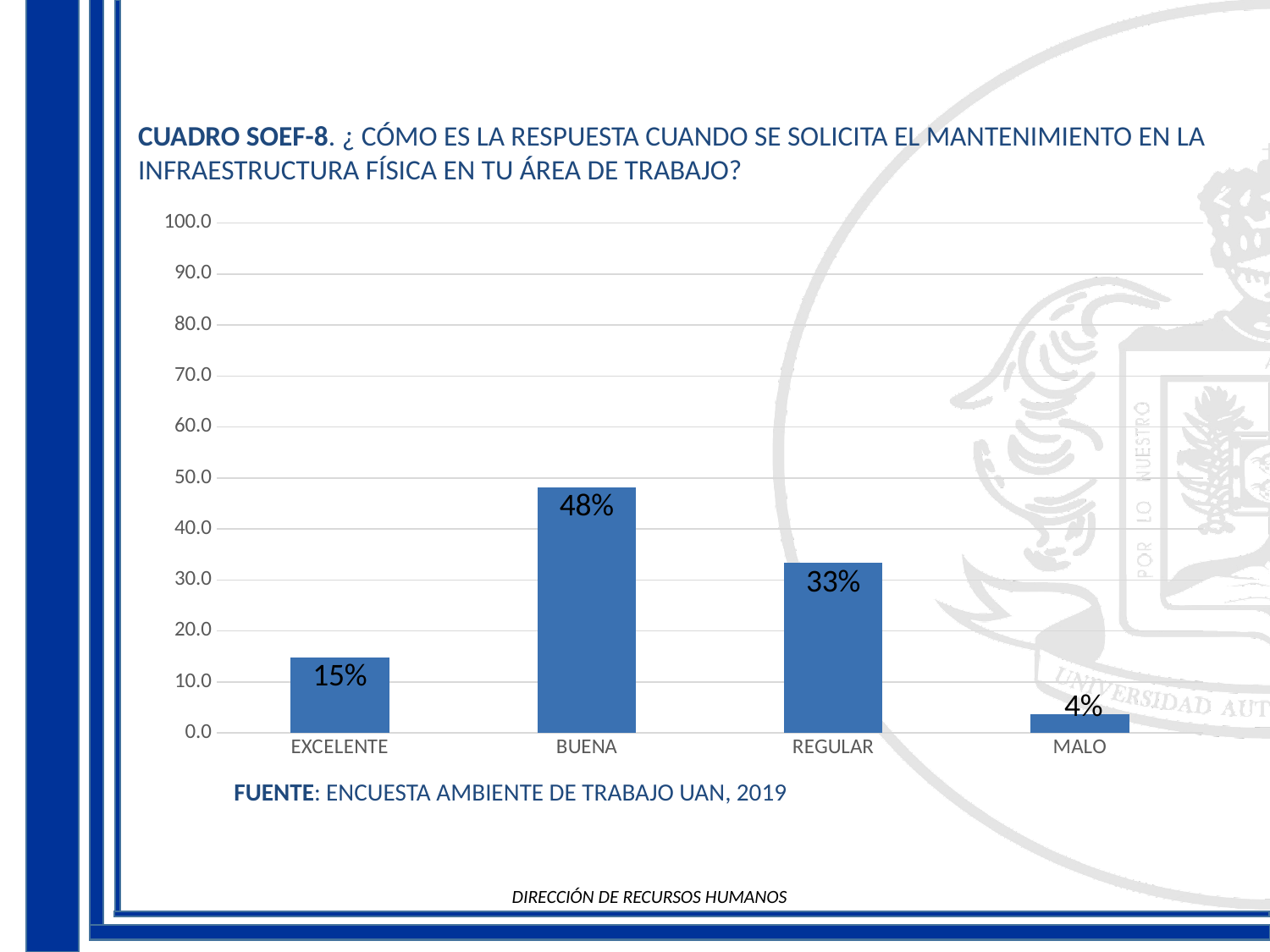
What is the highest value shown on the y axis? 100.0 Which category has the lowest value? MALO What is the difference between the values for BUENA and REGULAR? 15% Which category has the highest value? BUENA What is the value for BUENA? 48% Is the value for REGULAR greater or less than 40.0? less What is the value for EXCELENTE? 15% How many categories are shown on the x axis? 4 What is the value for MALO? 4% What kind of chart is shown on the slide? bar chart Which is larger, the value for EXCELENTE or the value for REGULAR? REGULAR What is the source cited below the chart? ENCUESTA AMBIENTE DE TRABAJO UAN, 2019